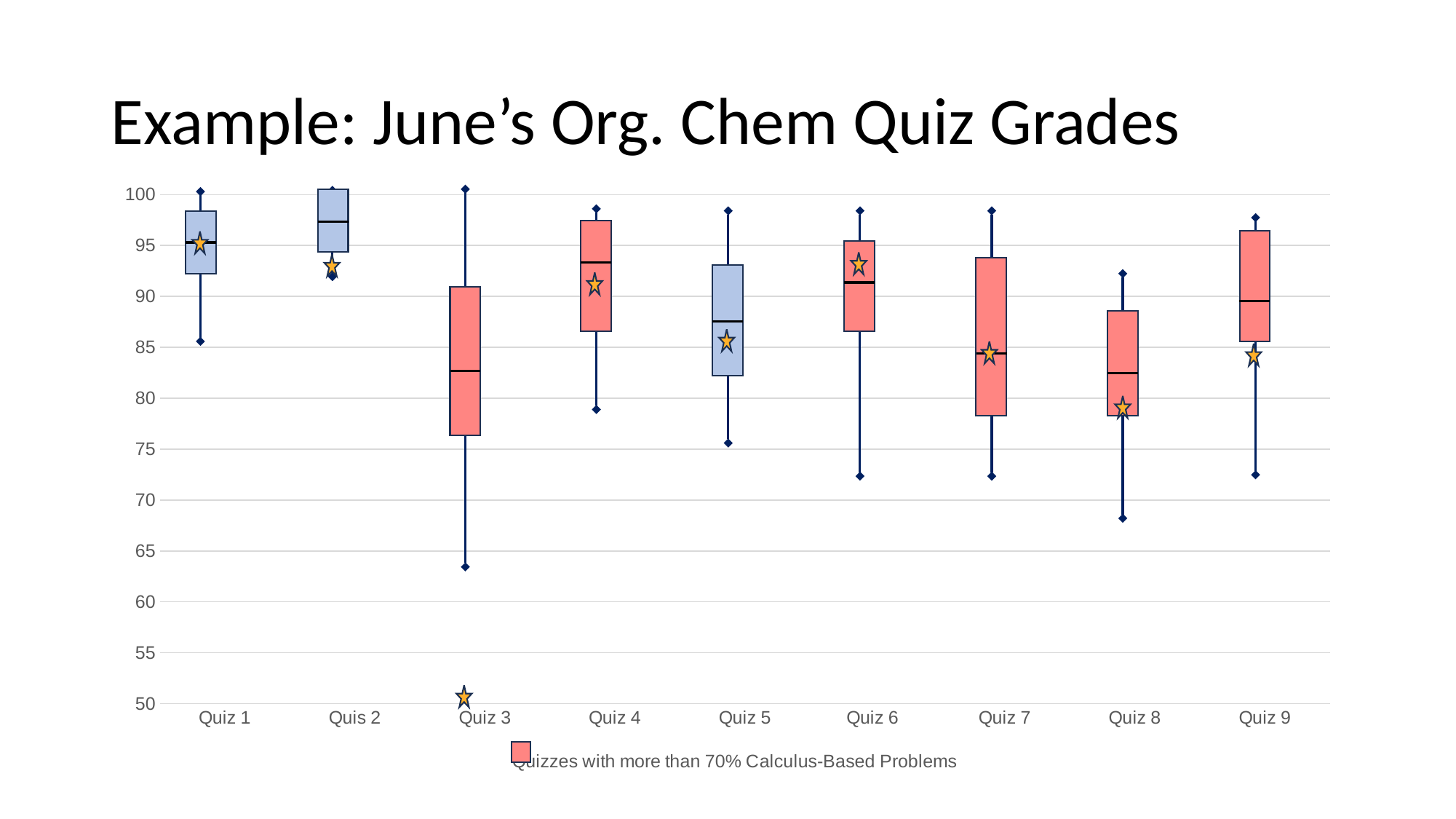
Which quiz has the lowest star marker? Quiz 3 Is the lower whisker end for Quiz 8 greater or less than 70? less Which quiz has the highest median line? Quis 2 Is the median for Quis 2 higher or lower than the median for Quiz 5? higher What is the title of the slide? Example: June's Org. Chem Quiz Grades Is the median for Quiz 4 greater or less than 90? greater Which quiz has the lowest minimum (lowest whisker end)? Quiz 3 What kind of chart is shown on the slide? Box-and-whisker (box plot) chart Is the median for Quiz 3 greater or less than 85? less How many quizzes are plotted along the x axis? 9 What does the legend entry with the red/pink box say? Quizzes with more than 70% Calculus-Based Problems